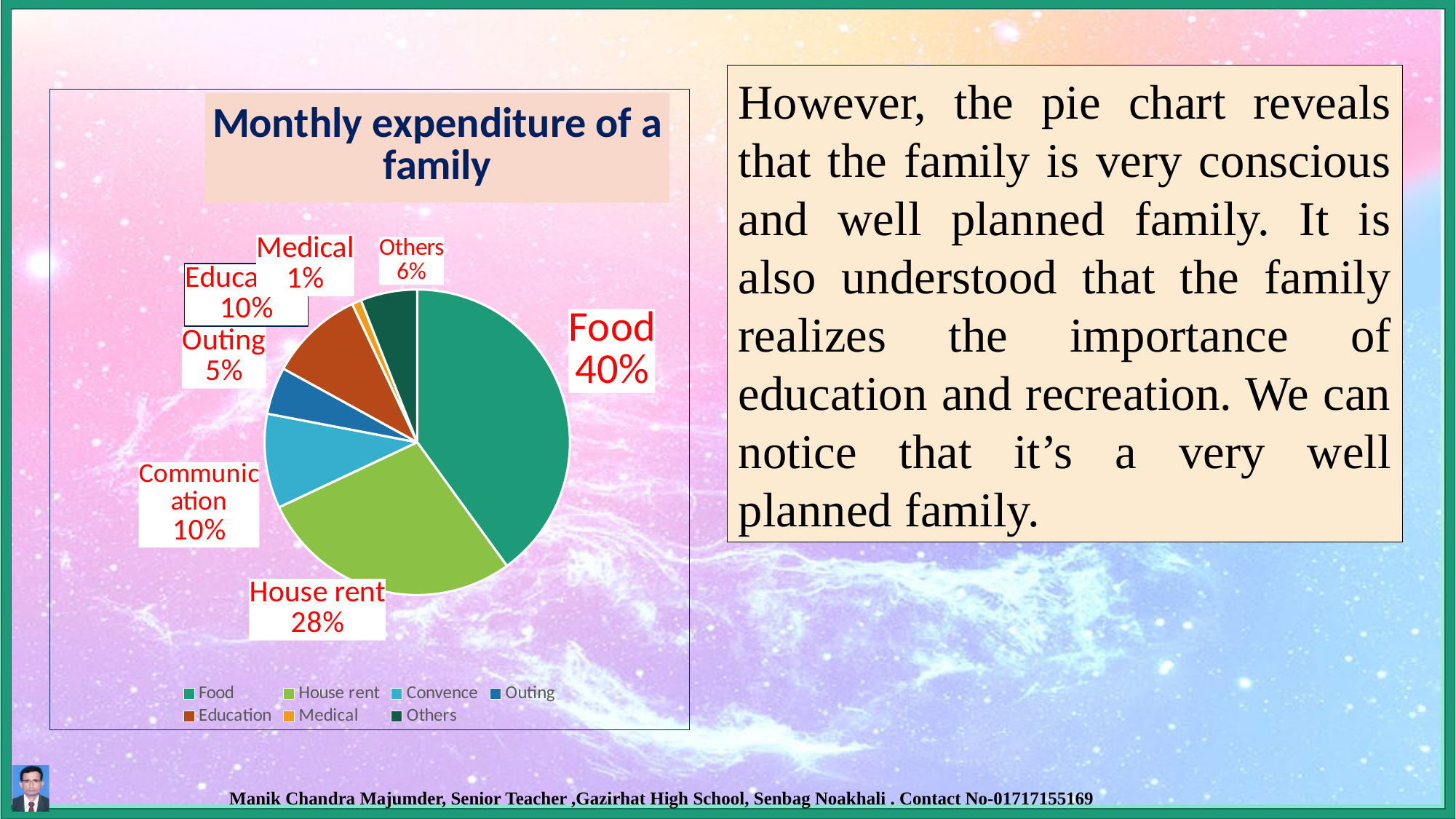
What percentage of the monthly expenditure goes to House rent? 28% Which is larger, the share for Others or the share for Outing? Others Which category takes the largest share of the monthly expenditure? Food Which category takes the smallest share of the monthly expenditure? Medical How many entries does the legend list? 7 What percentage of the monthly expenditure goes to Medical? 1% How many percentage points larger is the Food share than the House rent share? 12% What percentage of the monthly expenditure goes to Food? 40% How many slices does the pie chart have? 7 What percentage of the monthly expenditure goes to Others? 6% What is the title of the chart? Monthly expenditure of a family What kind of chart is shown on the slide? pie chart